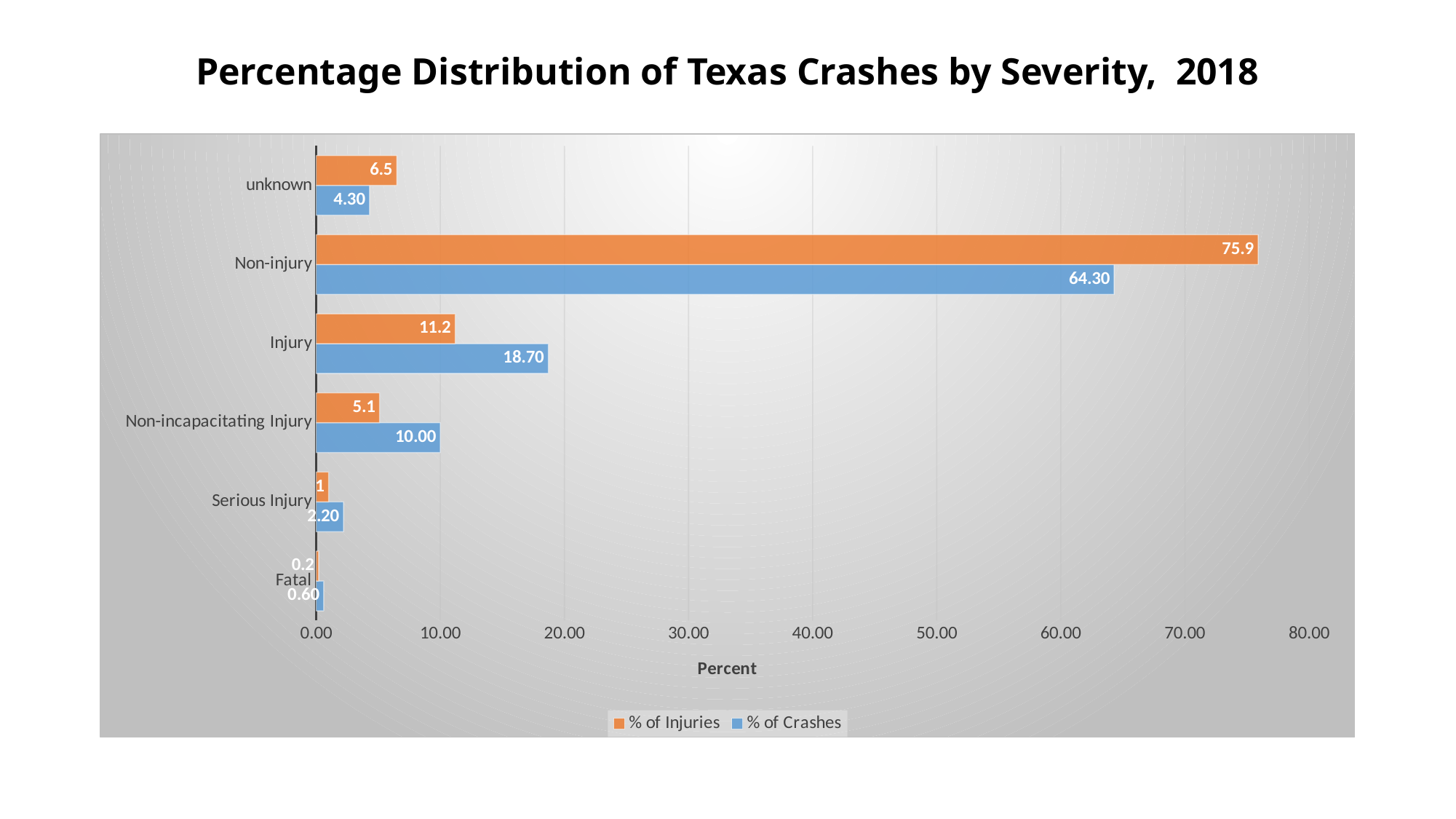
What is the % of Crashes value for Non-incapacitating Injury? 10.00 What kind of chart is shown on the slide? Bar chart What is the title of the chart? Percentage Distribution of Texas Crashes by Severity, 2018 How many series does the legend list? 2 What is the % of Injuries value for unknown? 6.5 Which category has the highest % of Crashes? Non-injury What is the % of Crashes value for Non-injury? 64.30 What is the % of Injuries value for Injury? 11.2 What is the difference between the % of Injuries and % of Crashes for Non-injury? 11.6 Which category has the lowest % of Injuries? Fatal Which is larger for Injury: % of Injuries or % of Crashes? % of Crashes How many severity categories are shown on the chart? 6